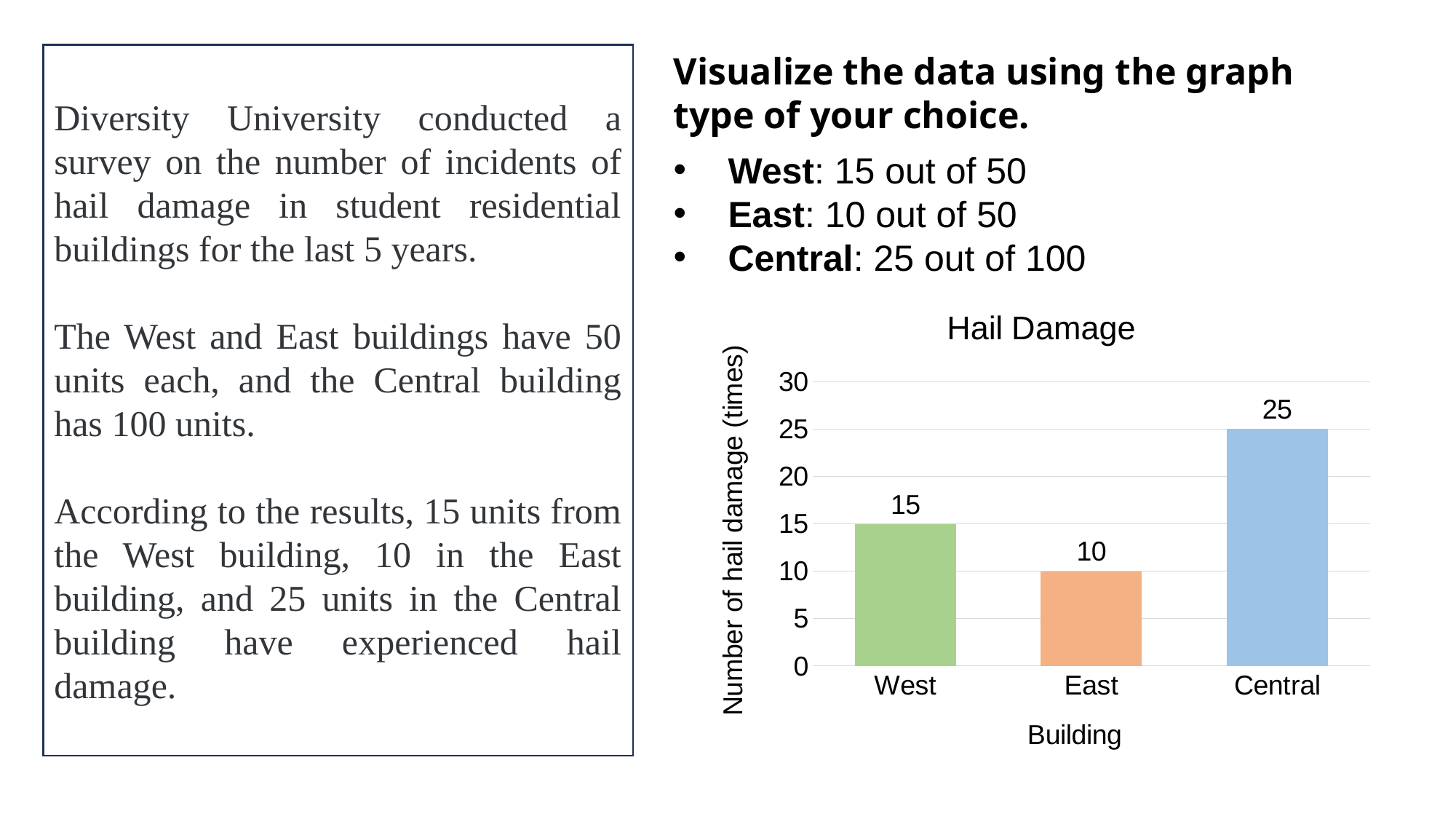
Which building has the lowest number of hail damage incidents? East What is the value for West in the Hail Damage chart? 15 What is the difference between the values for West and East? 5 Is the value for Central greater or less than 20? greater What kind of chart is shown on the slide? bar chart Which building has the highest number of hail damage incidents? Central Which is larger, the value for West or the value for East? West How many buildings are shown in the chart? 3 What is the difference between the values for Central and West? 10 What is the value for Central in the Hail Damage chart? 25 What is the value for East in the Hail Damage chart? 10 What is the title of the chart? Hail Damage